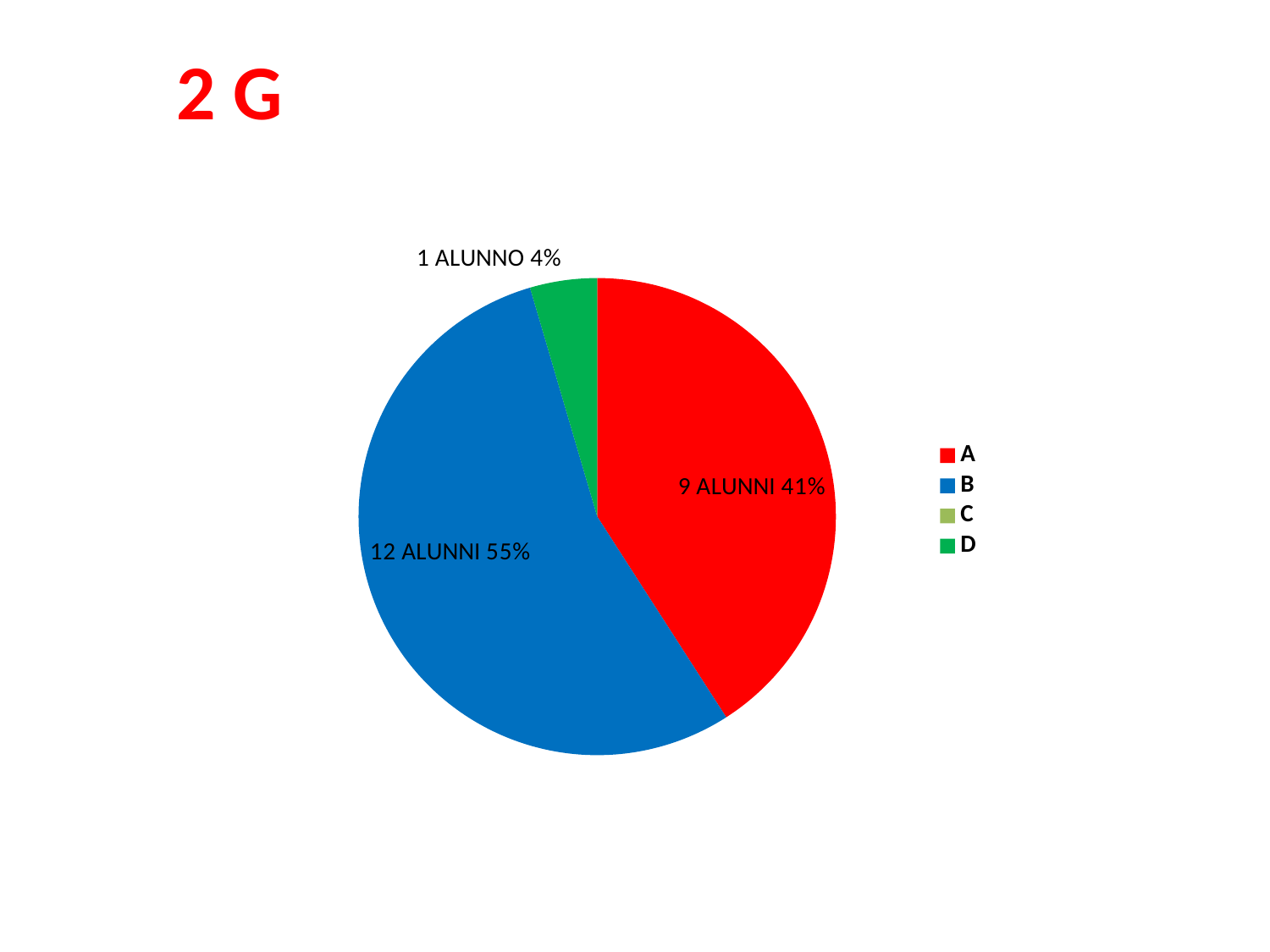
How many students (alunni) are in category B? 12 What percentage share does slice A have? 41% Which is larger, the share for A or the share for B? B What is the difference in number of students between category B and category A? 3 What kind of chart is shown on the slide? pie chart What percentage share does slice D have? 4% How many entries does the legend list? 4 Which category has the largest slice of the pie? B What colour is the slice for category A? red What percentage share does slice B have? 55% How many students (alunni) are in category A? 9 Which of the visible slices is the smallest? D